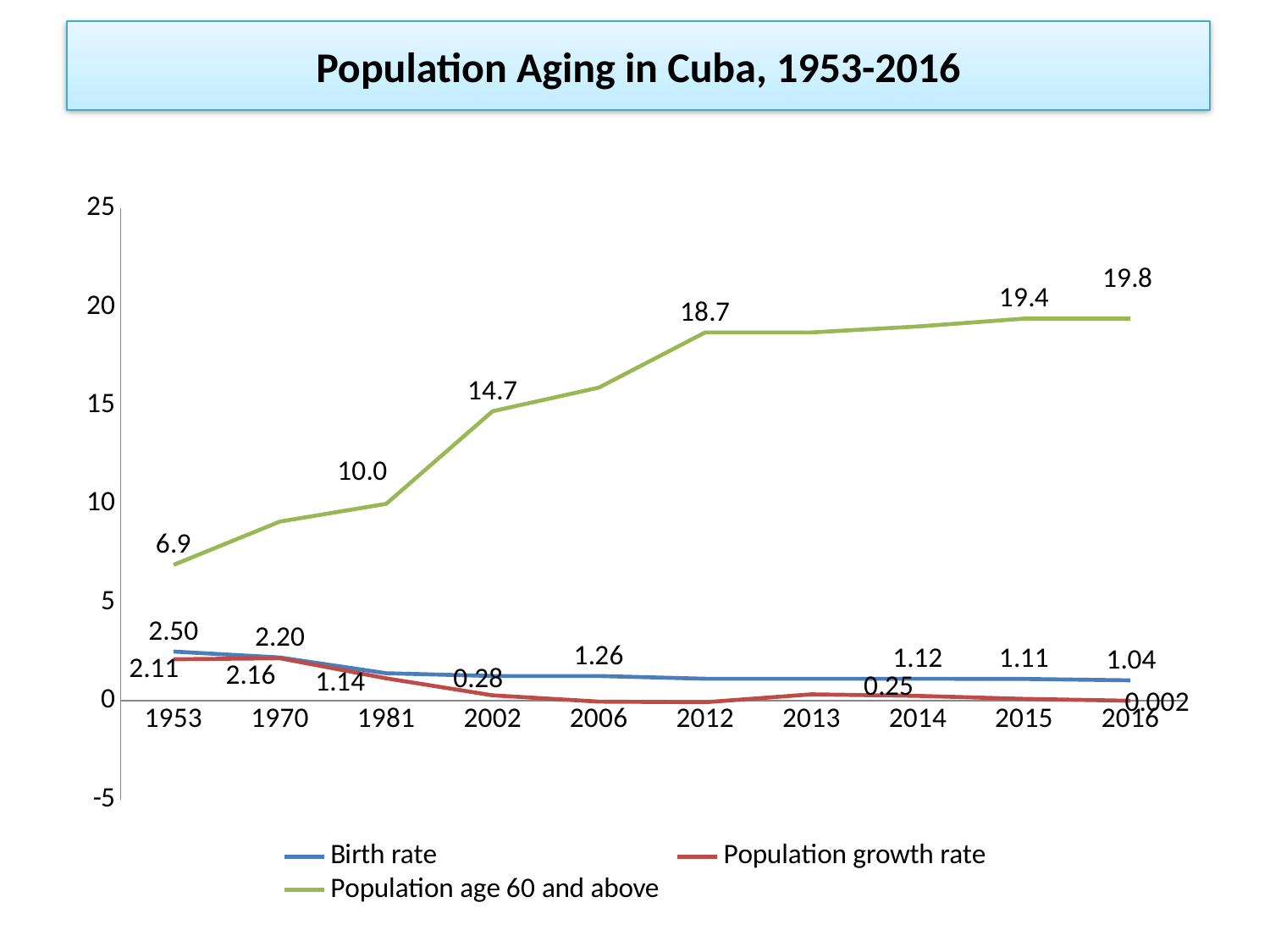
What is the value for Population age 60 and above in 1953? 6.9 Is the value for Population age 60 and above in 1970 greater or less than 10? less What is the value for Population age 60 and above in 2016? 19.8 What is the difference between the Population age 60 and above values in 2016 and 1953? 12.9 What is the Population growth rate value in 2016? 0.002 What is the Birth rate value in 1953? 2.50 Does the Population age 60 and above series rise or fall from 1953 to 2016? Rise How many series does the legend list? 3 What type of chart is shown on the slide? Line chart How many years are shown on the x axis? 10 In which year is Population age 60 and above highest? 2016 Which year has the larger Population age 60 and above value, 2002 or 2012? 2012